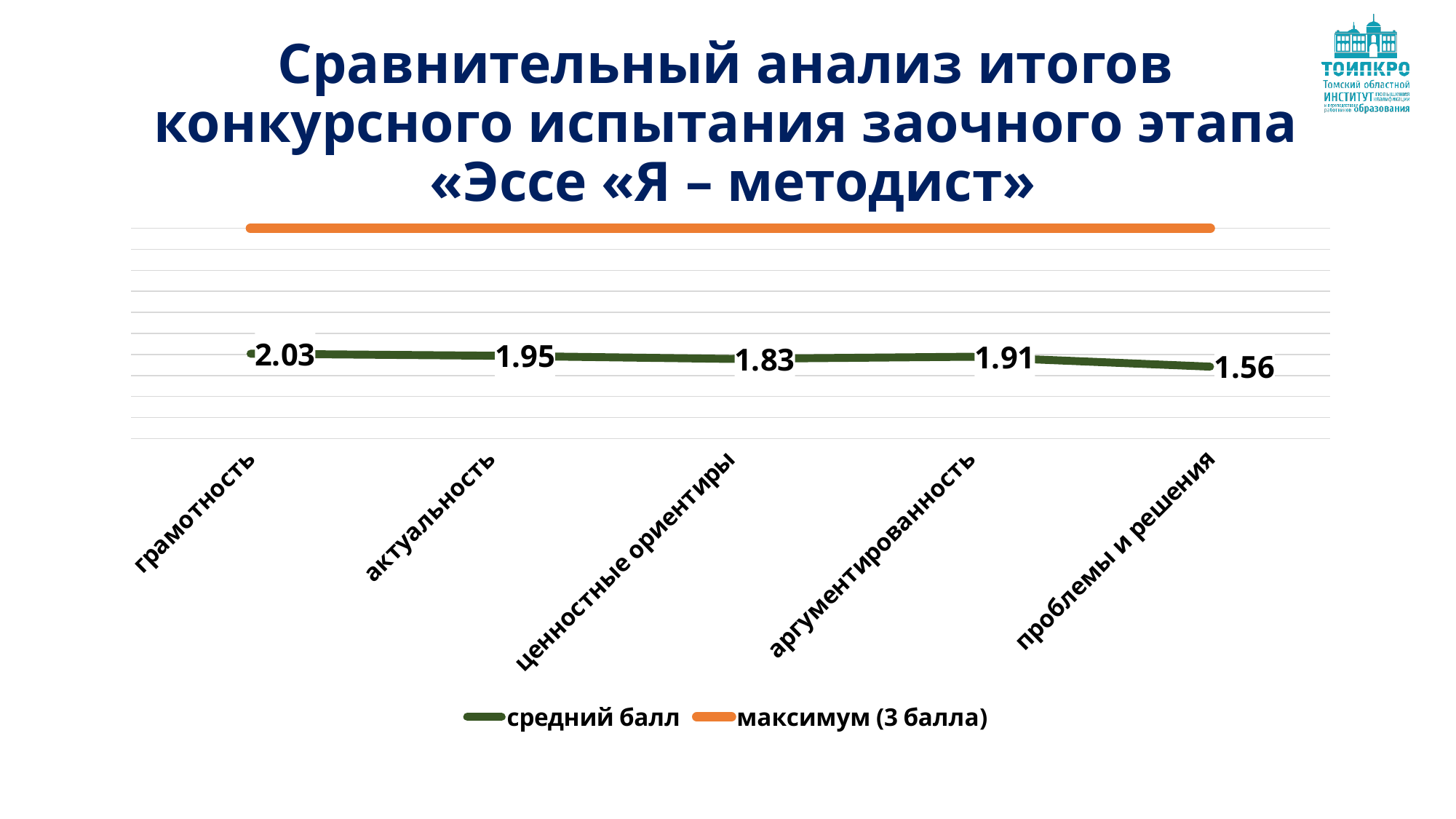
Which criterion has the highest average score? грамотность What is the difference between the average scores for грамотность and проблемы и решения? 0.47 What is the average score (средний балл) for аргументированность? 1.91 How many series does the legend list? 2 Which has a higher average score, актуальность or аргументированность? актуальность What is the average score (средний балл) for проблемы и решения? 1.56 What is the difference between the average scores for аргументированность and ценностные ориентиры? 0.08 What is the average score (средний балл) for грамотность? 2.03 What kind of chart is shown on the slide? line chart How many criteria are plotted along the x axis? 5 Which criterion has the lowest average score? проблемы и решения What is the average score (средний балл) for ценностные ориентиры? 1.83